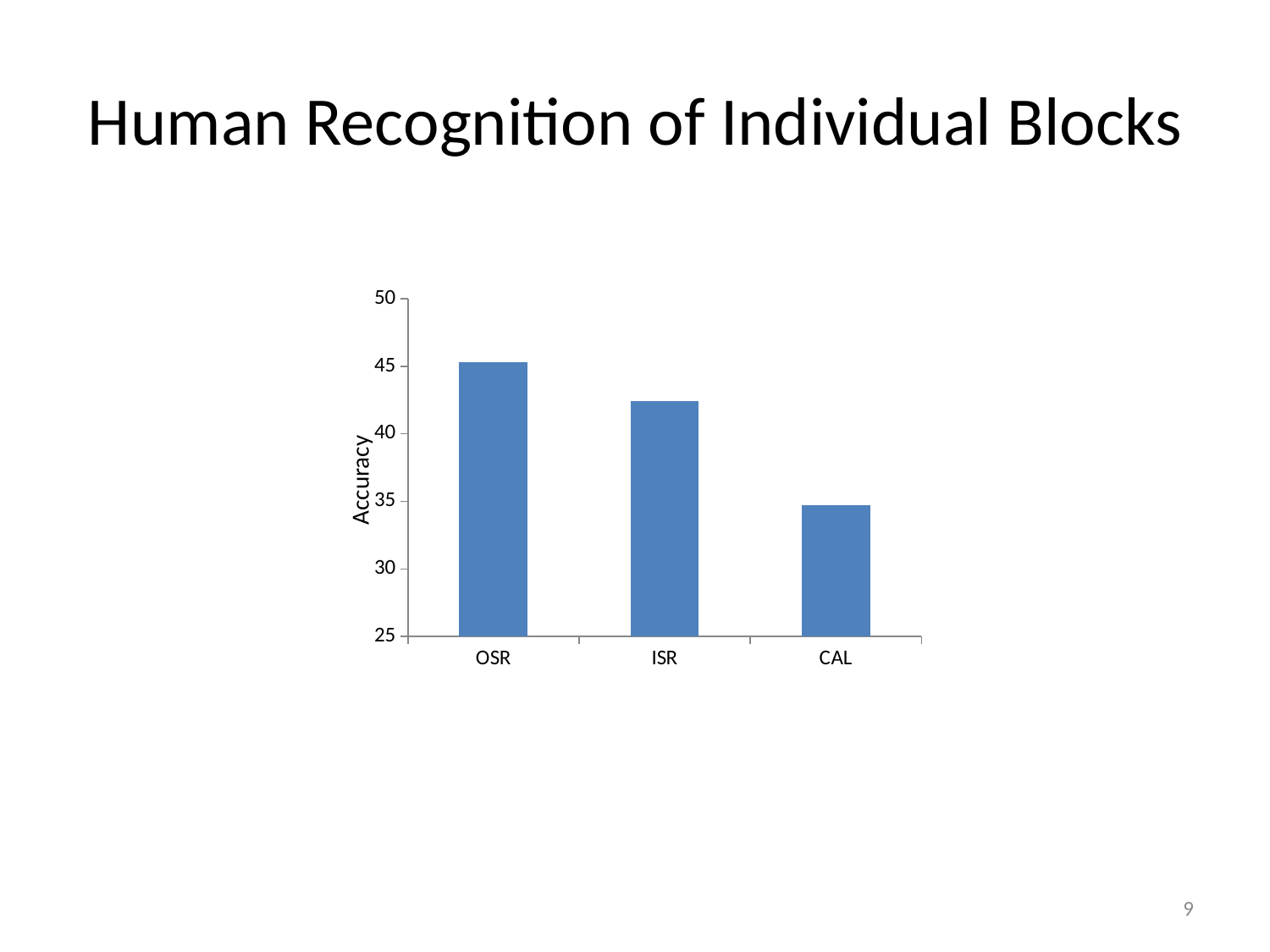
How many categories are shown on the x axis of the chart? 3 Is the accuracy for ISR greater or less than 40? greater Which category has the highest accuracy? OSR Is the accuracy for ISR greater or less than 45? less What is the label on the vertical axis of the chart? Accuracy Which has a higher accuracy, ISR or CAL? ISR Which category has the lowest accuracy? CAL Which has a higher accuracy, OSR or ISR? OSR What kind of chart is shown on the slide? bar chart Do the values rise or fall from left to right across the categories? fall